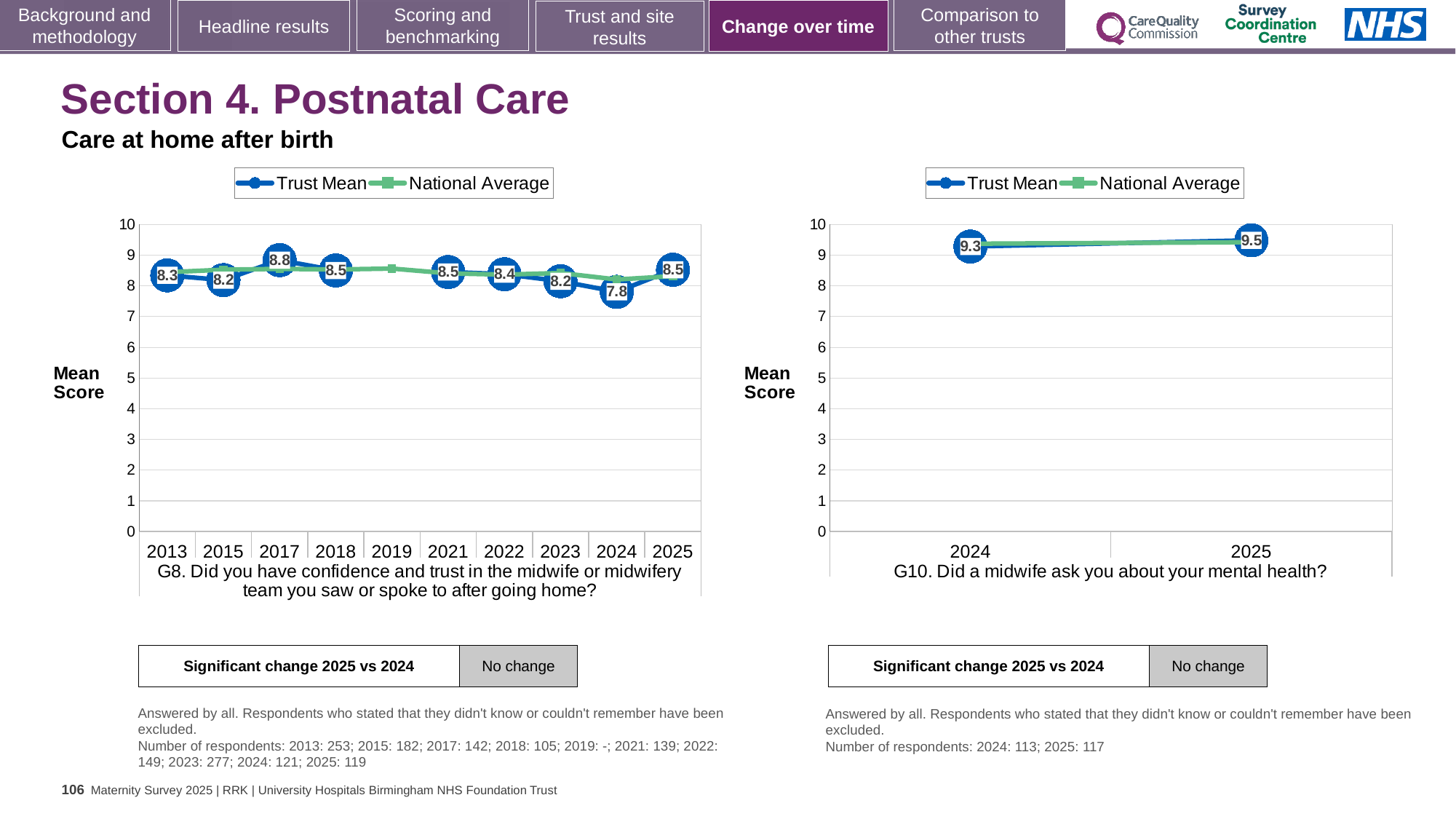
How many series does the legend of the G10 chart (right) list? 2 On the G8 chart (left), is the National Average for 2019 greater or less than 8? greater On the G10 chart (right), what is the difference between the Trust Mean for 2025 and for 2024? 0.2 On the G8 chart (left), what is the difference between the Trust Mean for 2025 and for 2024? 0.7 On the G8 chart (left), what is the Trust Mean for 2017? 8.8 On the G10 chart (right), does the Trust Mean rise or fall from 2024 to 2025? rise On the G8 chart (left), which year has the lowest Trust Mean? 2024 On the G8 chart (left), what is the Trust Mean for 2024? 7.8 On the G8 chart (left), how many years are shown on the x axis? 10 On the G8 chart (left), is the Trust Mean higher in 2013 or in 2015? 2013 On the G10 chart (right), what is the Trust Mean for 2024? 9.3 On the G8 chart (left), which year has the highest Trust Mean? 2017